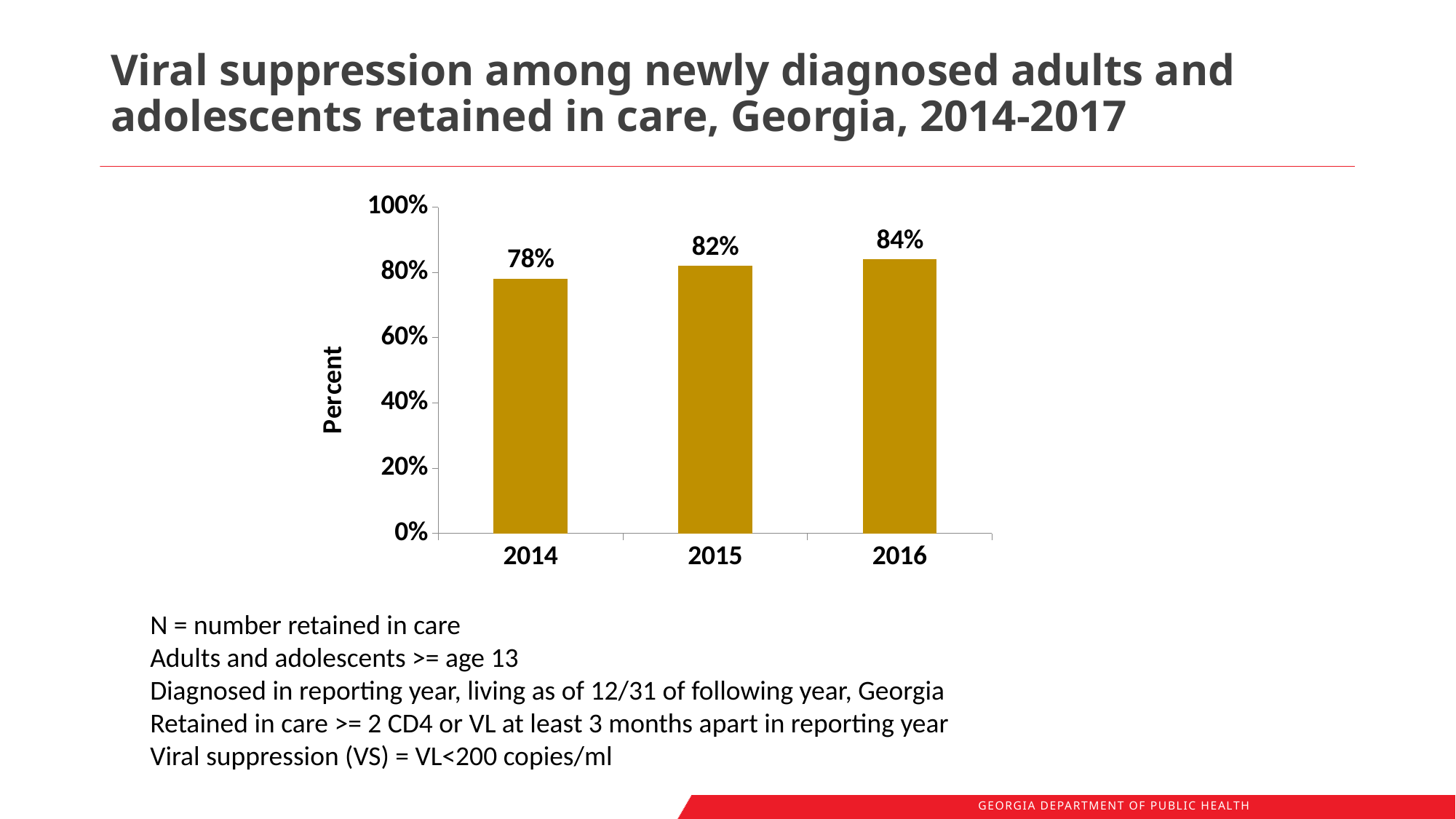
Which year has the lowest viral suppression percentage? 2014 Do the viral suppression percentages rise or fall from 2014 to 2016? Rise What is the difference in viral suppression percentage between 2015 and 2014? 4% What is the viral suppression percentage for 2014? 78% Is the value for 2014 greater or less than 80%? less How many years are shown on the x axis of the chart? 3 What is the viral suppression percentage for 2015? 82% What kind of chart is shown on the slide? Bar chart Which year has the highest viral suppression percentage? 2016 What is the viral suppression percentage for 2016? 84% What is the difference in viral suppression percentage between 2016 and 2014? 6% Which year has a higher viral suppression percentage, 2015 or 2016? 2016